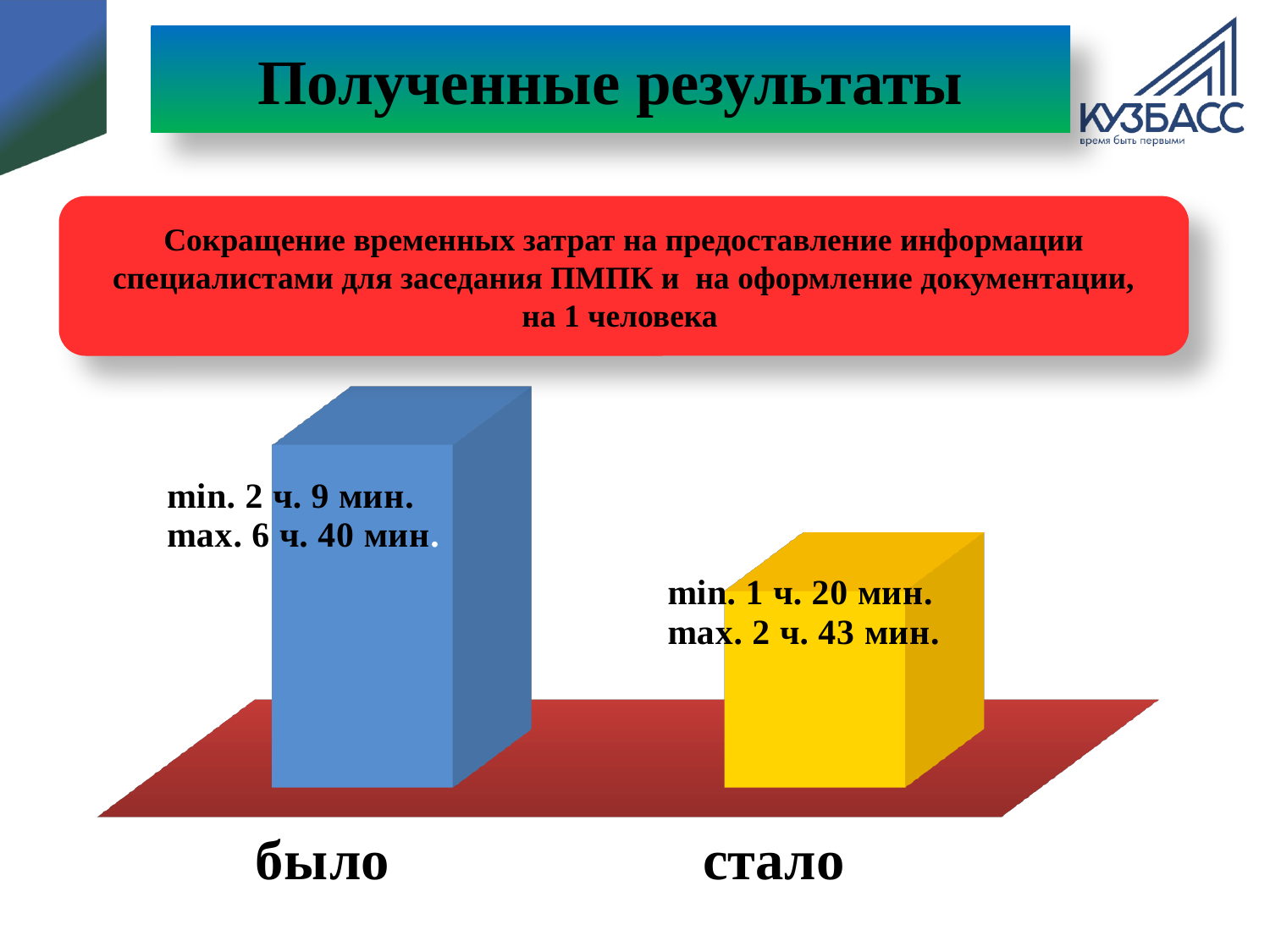
By how much did the maximum time decrease from "было" to "стало"? 3 ч. 57 мин. What is the minimum time shown for the "стало" bar? 1 ч. 20 мин. What kind of chart is shown on the slide? bar chart Which category has the taller bar, "было" or "стало"? было What is the maximum time shown for the "было" bar? 6 ч. 40 мин. Which category has the lowest bar? стало Do the values rise or fall from "было" to "стало"? fall Which category has the highest bar? было What is the maximum time shown for the "стало" bar? 2 ч. 43 мин. What colour is the "стало" bar? yellow How many bars (categories) does the chart show? 2 What is the minimum time shown for the "было" bar? 2 ч. 9 мин.